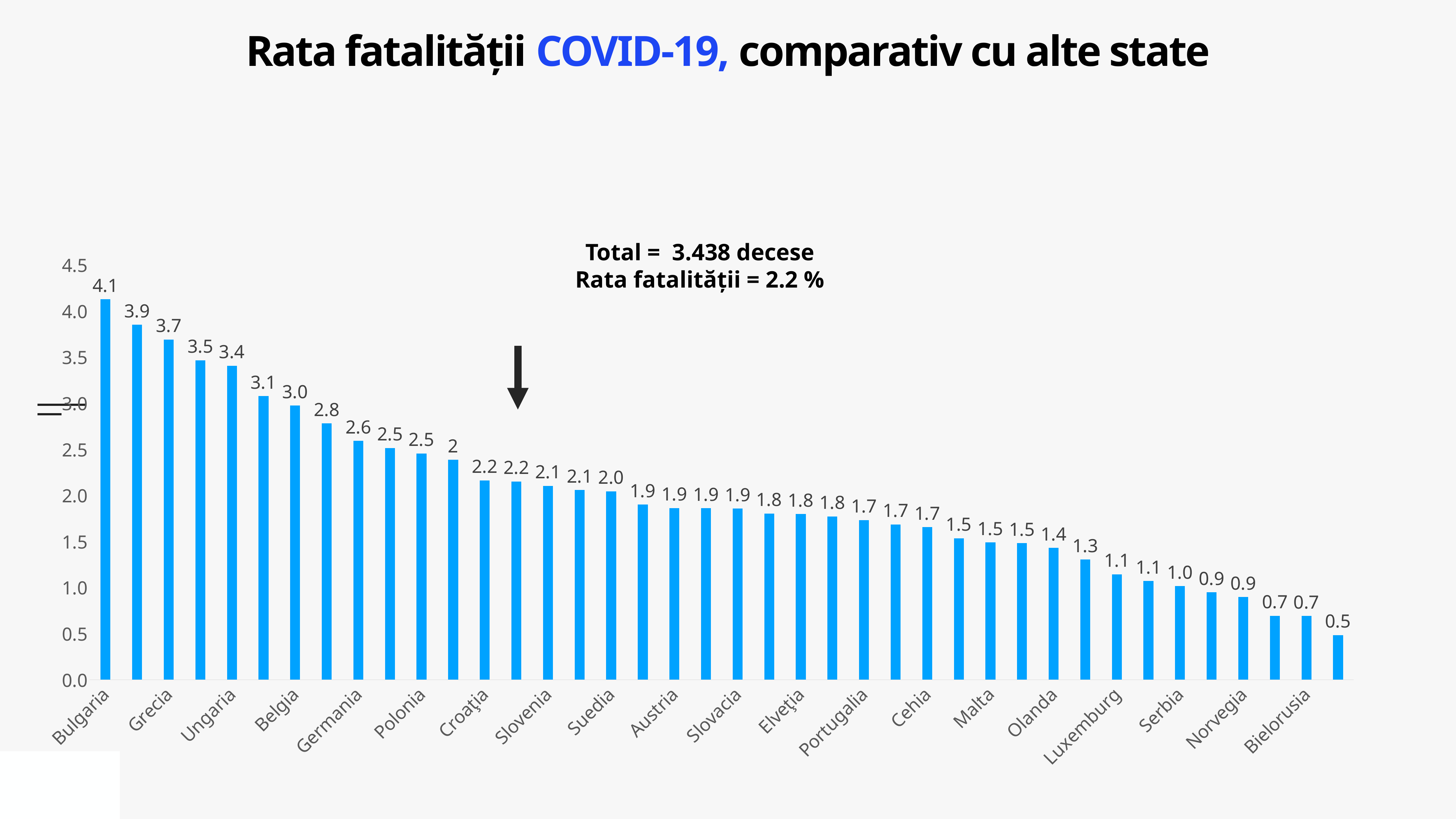
Do the bar values rise or fall from left to right along the x axis? fall Which country has the highest fatality rate in the chart? Bulgaria What is the value shown for Bulgaria? 4.1 Is the value for Bulgaria greater or less than 4.0? greater What is the title of the slide? Rata fatalității COVID-19, comparativ cu alte state What kind of chart is shown on the slide? bar chart What is the difference between the highest bar value (4.1) and the lowest bar value (0.5)? 3.6 What fatality rate is stated in the text annotation above the chart? 2.2 % What is the lowest value shown on any bar in the chart? 0.5 What is the highest value shown on any bar in the chart? 4.1 How many country labels are shown on the x axis? 20